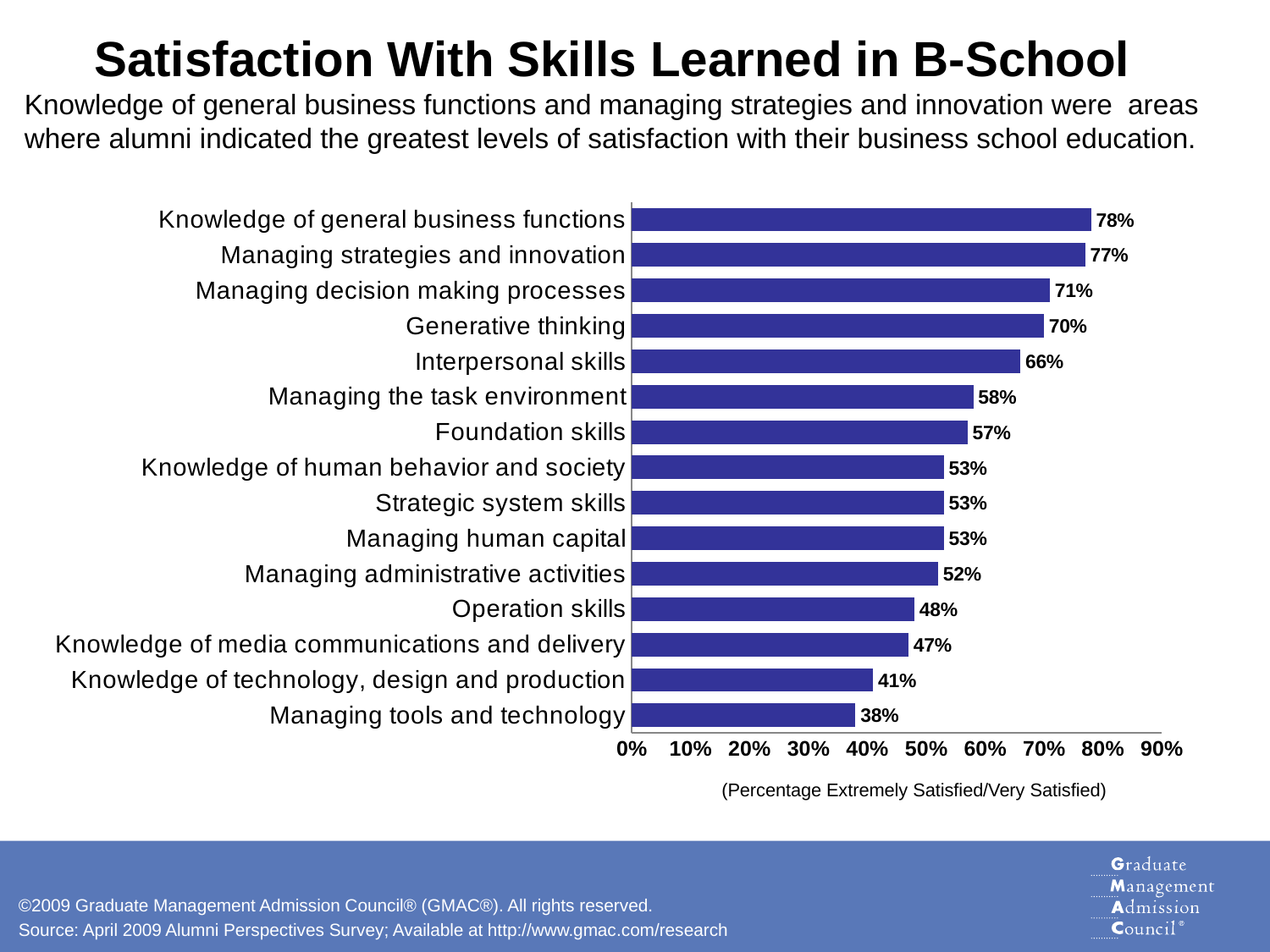
What is the value for Operation skills? 48% What is the value for Knowledge of general business functions? 78% What is the value for Managing tools and technology? 38% What is the title of the slide? Satisfaction With Skills Learned in B-School What is the difference between the values for Generative thinking and Foundation skills? 13% What kind of chart is shown on the slide? Bar chart How many categories are shown in the chart? 15 Which is larger, the value for Managing the task environment or the value for Managing administrative activities? Managing the task environment What is the value for Interpersonal skills? 66% What is the difference between the values for Knowledge of general business functions and Managing tools and technology? 40% Which category has the highest value? Knowledge of general business functions Which category has the lowest value? Managing tools and technology